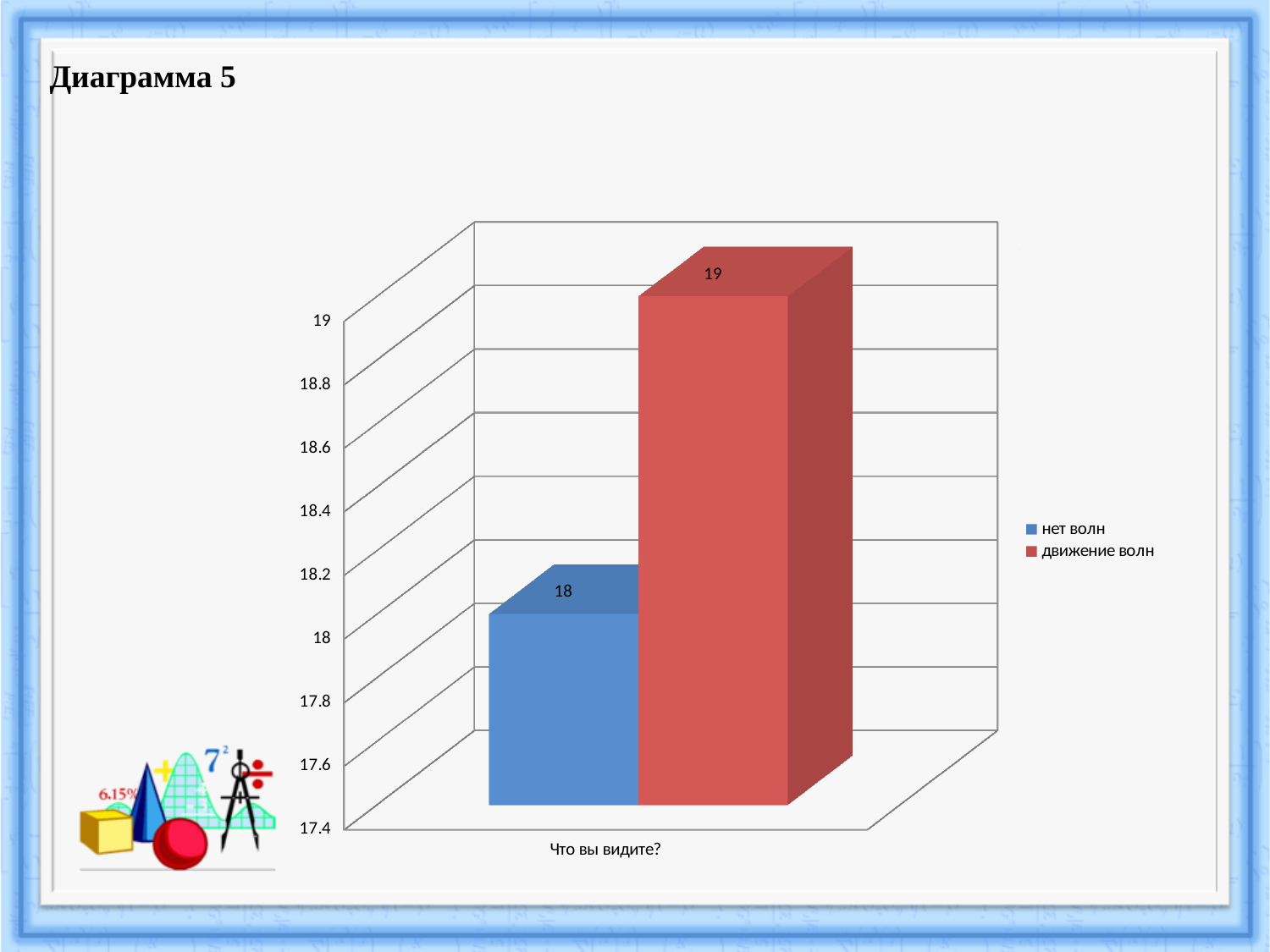
What is the category label shown on the x axis? Что вы видите? What kind of chart is shown on the slide? bar chart Which is larger, the value for "нет волн" or the value for "движение волн"? движение волн Is the value for "нет волн" greater or less than 18.4? less What is the value for "движение волн"? 19 Which series has the higher value? движение волн How many series does the legend list? 2 What colour is the bar for "движение волн"? red What is the difference between the values for "движение волн" and "нет волн"? 1 Which series has the lower value? нет волн What is the value for "нет волн"? 18